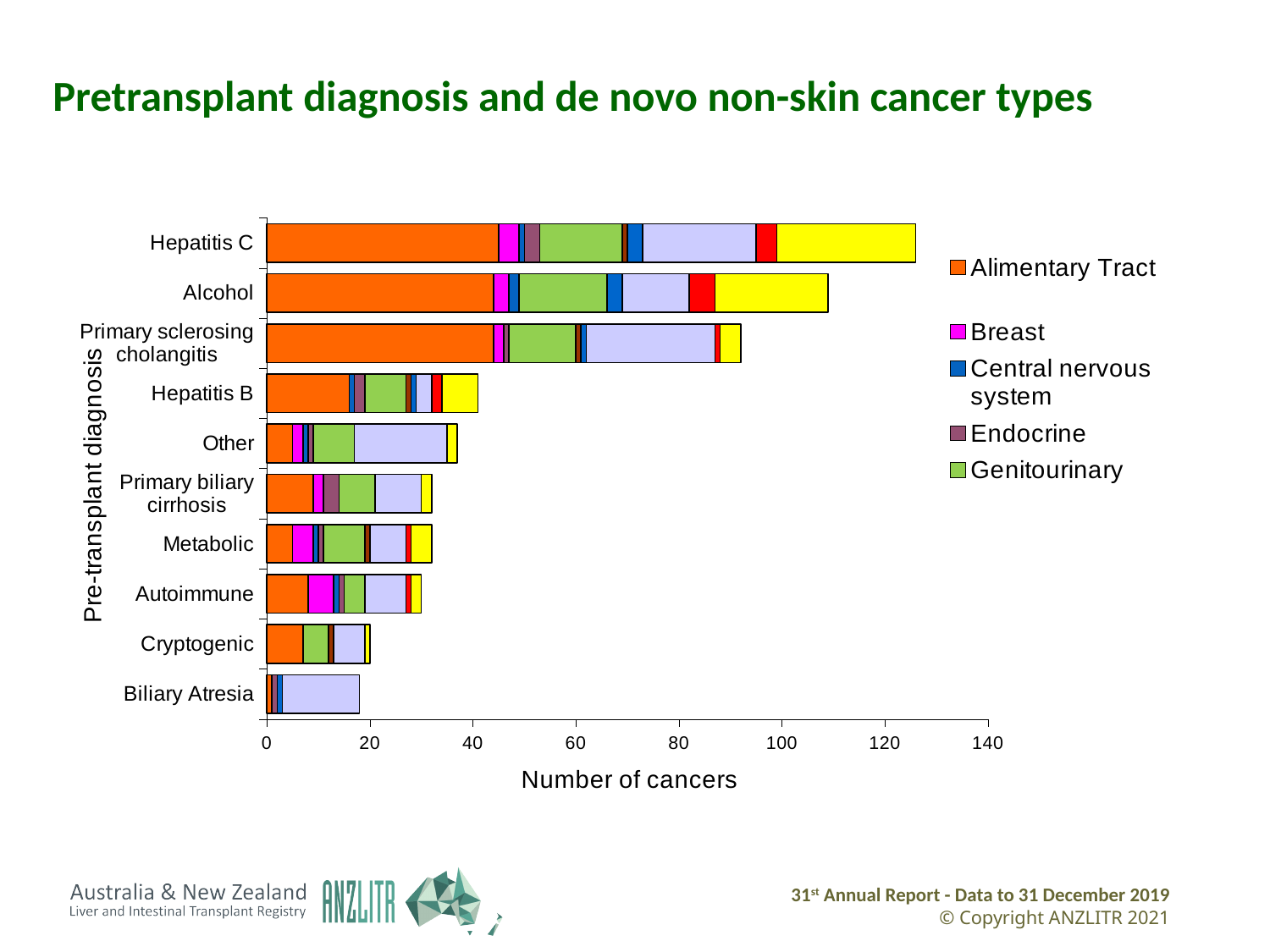
What kind of chart is shown on the slide? Stacked bar chart What is the title of the slide? Pretransplant diagnosis and de novo non-skin cancer types What is the label on the x axis of the chart? Number of cancers Is the total number of cancers for Primary sclerosing cholangitis greater or less than 100? less How many series does the legend list? 5 Is the total number of cancers for Biliary Atresia greater or less than 20? less Which pre-transplant diagnosis has the highest total number of cancers? Hepatitis C Is the total number of cancers for Hepatitis C greater or less than 120? greater Which has a larger total number of cancers, Alcohol or Primary sclerosing cholangitis? Alcohol How many pre-transplant diagnosis categories are plotted on the chart? 10 Which pre-transplant diagnosis has the lowest total number of cancers? Biliary Atresia